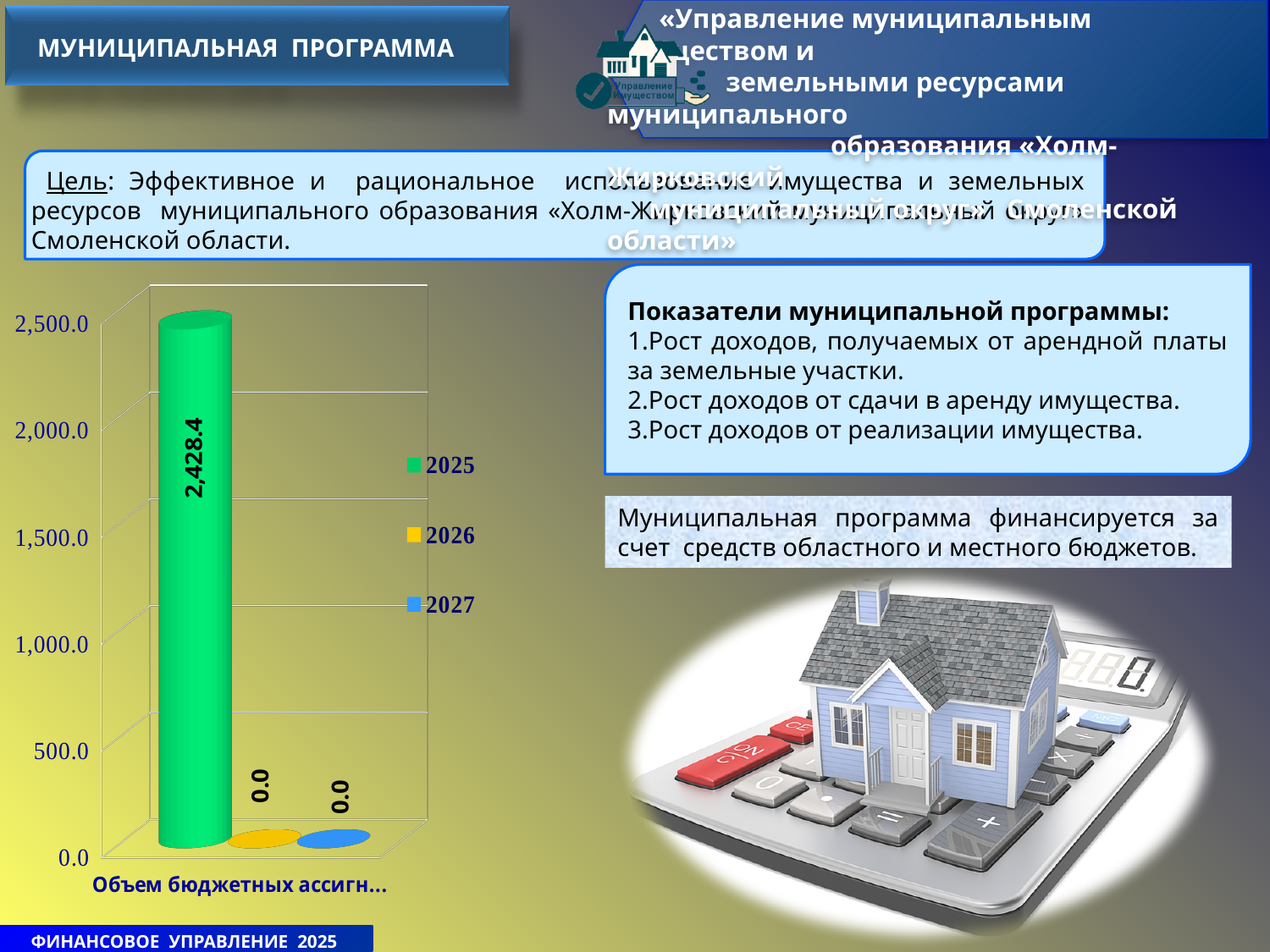
What is the highest value shown on the vertical axis of the chart? 2,500.0 What is the value for the 2025 series in the chart? 2,428.4 Which is larger, the value for 2025 or the value for 2027? 2025 Do the values fall or rise from 2025 to 2027 in the chart? fall What is the difference between the 2025 value and the 2026 value? 2,428.4 Is the value for 2025 greater or less than 2,000.0? greater What is the value for the 2027 series in the chart? 0.0 What is the value for the 2026 series in the chart? 0.0 How many series does the legend list? 3 What colour is the bar for the 2025 series? green Which series has the highest value in the chart? 2025 What kind of chart is shown on the slide? bar chart